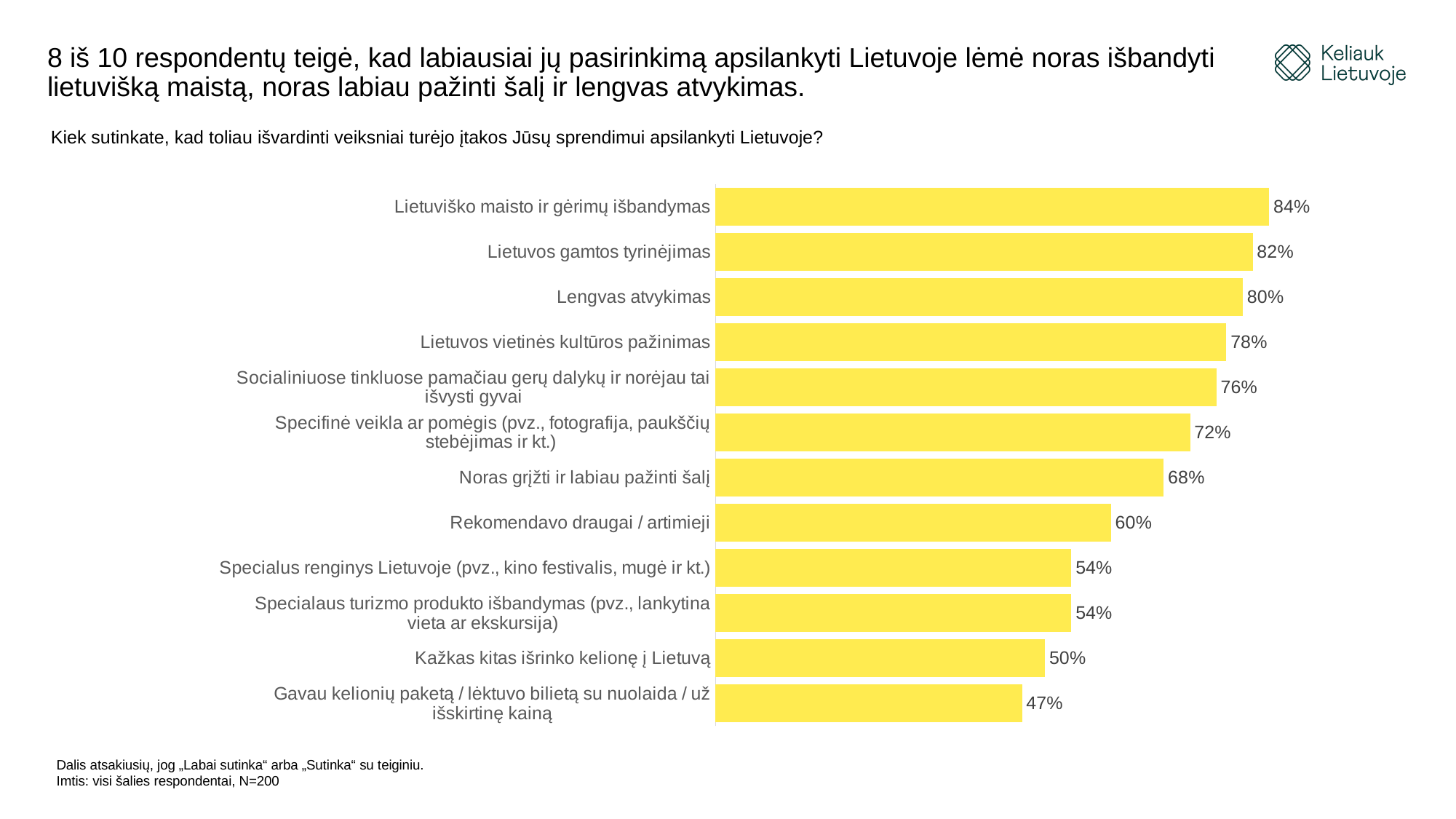
What is the value for "Lietuviško maisto ir gėrimų išbandymas"? 84% Which is larger: the value for "Lietuvos gamtos tyrinėjimas" or the value for "Lietuvos vietinės kultūros pažinimas"? Lietuvos gamtos tyrinėjimas Which category has the lowest value? Gavau kelionių paketą / lėktuvo bilietą su nuolaida / už išskirtinę kainą How many categories are shown in the chart? 12 Which category has the highest value? Lietuviško maisto ir gėrimų išbandymas What is the value for "Rekomendavo draugai / artimieji"? 60% What kind of chart is shown on the slide? Bar chart What is the sample size (N) stated below the chart? N=200 What is the value for "Kažkas kitas išrinko kelionę į Lietuvą"? 50% What is the difference between the values for "Lengvas atvykimas" and "Noras grįžti ir labiau pažinti šalį"? 12% What colour are the bars in the chart? Yellow What is the value for "Specifinė veikla ar pomėgis (pvz., fotografija, paukščių stebėjimas ir kt.)"? 72%